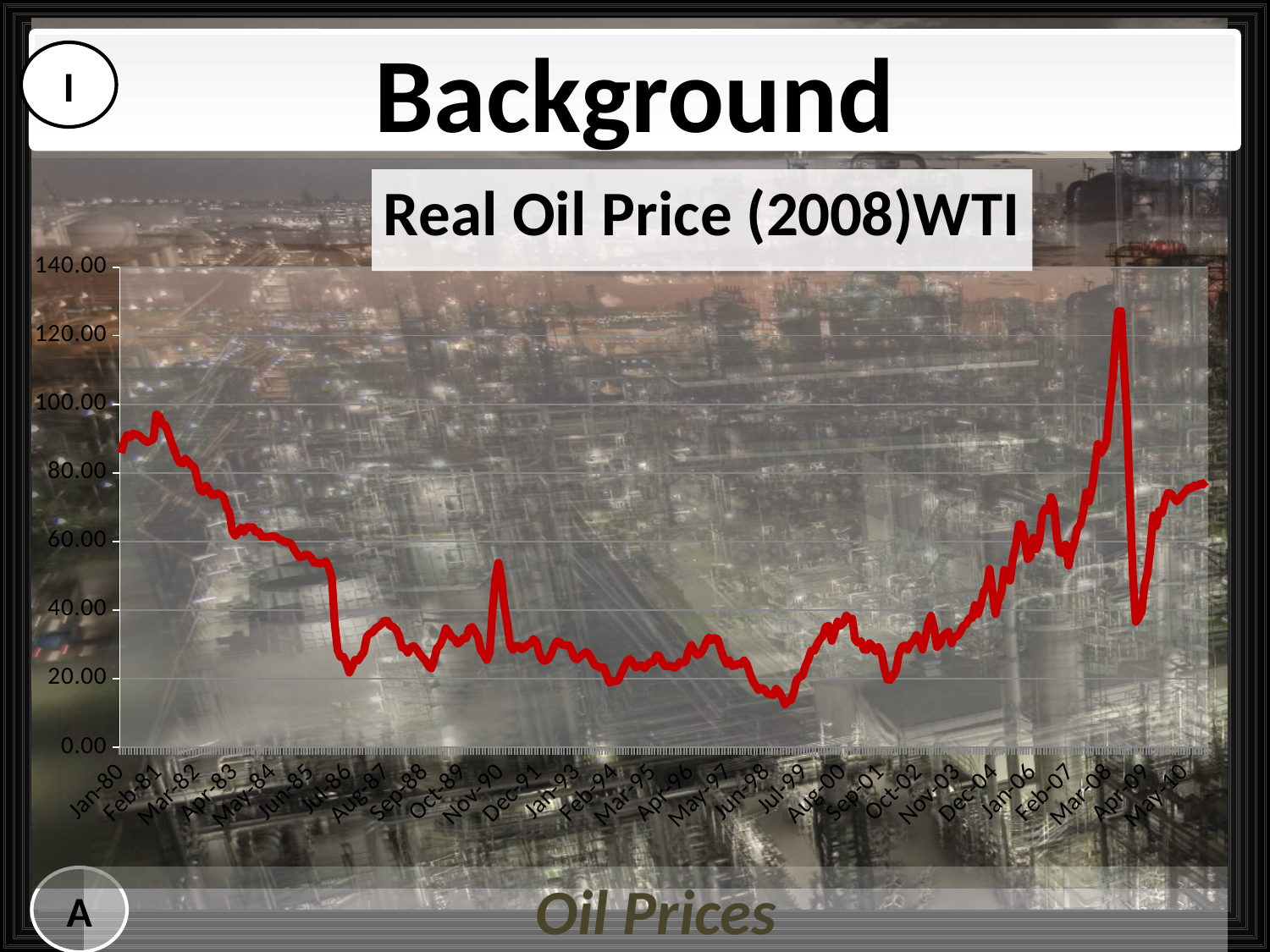
Is the value at May-10 greater or less than 80? less Which is larger, the value at Jan-80 or the value at Jul-86? Jan-80 Does the line rise or fall between Jan-80 and Jul-86? fall What kind of chart is shown on the slide? line chart Is the value at Jul-86 greater or less than 40? less Which is larger, the value at Jun-98 or the value at May-10? May-10 Is the value at Jan-80 greater or less than 80? greater What colour is the line plotted on the chart? red Does the line rise or fall between Nov-03 and Mar-08? rise What is the title of the chart? Real Oil Price (2008)WTI